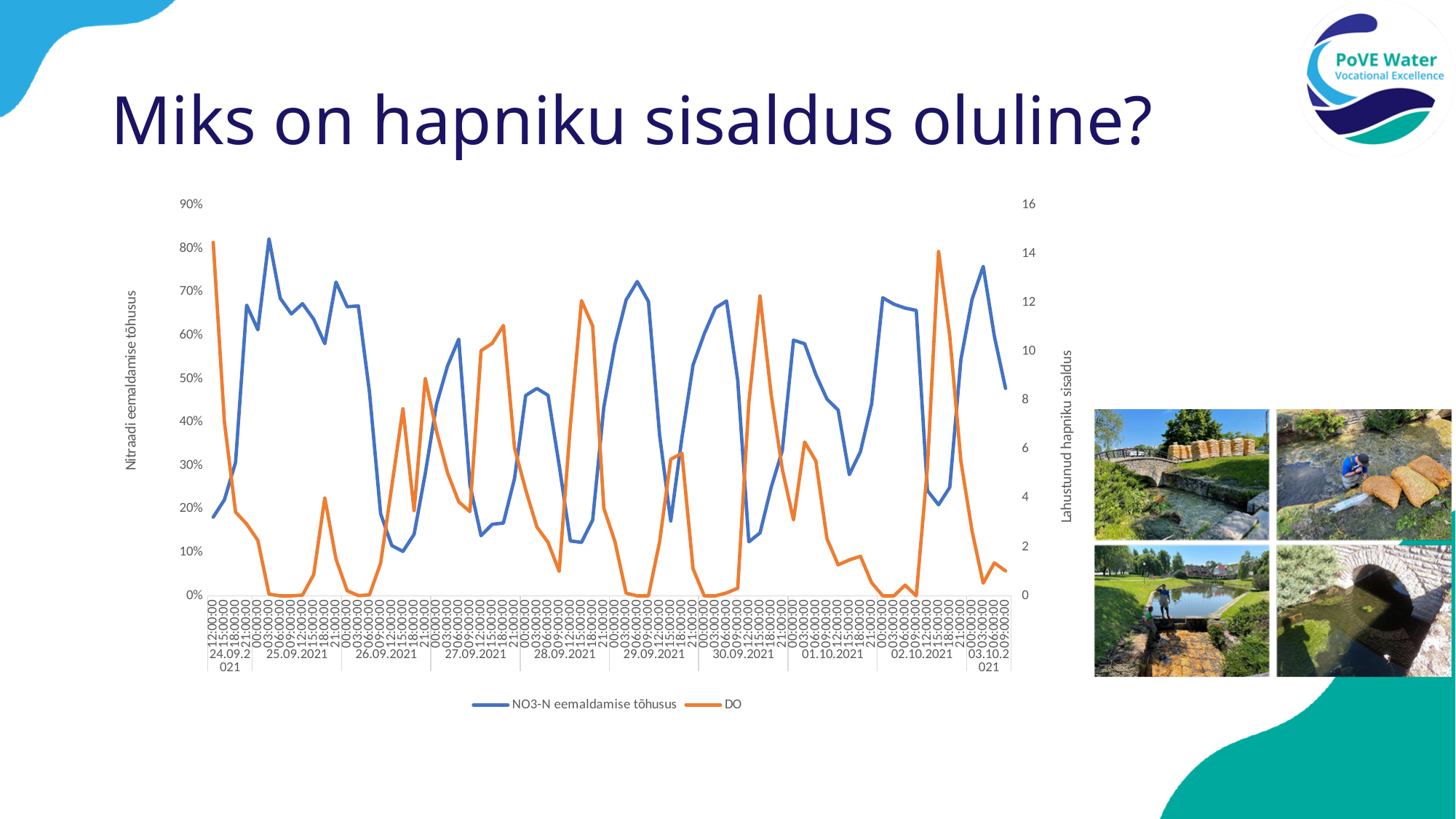
Which date is the first shown on the x axis of the chart? 24.09.2021 How many series does the chart legend list? 2 What is the highest tick value shown on the left vertical axis? 90% Which date is the last shown on the x axis of the chart? 03.10.2021 What type of chart is shown on the slide? line chart What is the highest tick value shown on the right vertical axis? 16 What are the two series named in the chart legend? NO3-N eemaldamise tõhusus and DO Is the peak NO3-N eemaldamise tõhusus value on 25.09.2021 greater or less than 70%? greater What is the title of the left vertical axis of the chart? Nitraadi eemaldamise tõhusus Is the DO value at the first point (24.09.2021 12:00:00) greater or less than 12? greater Is the peak DO value on 02.10.2021 greater or less than 12? greater